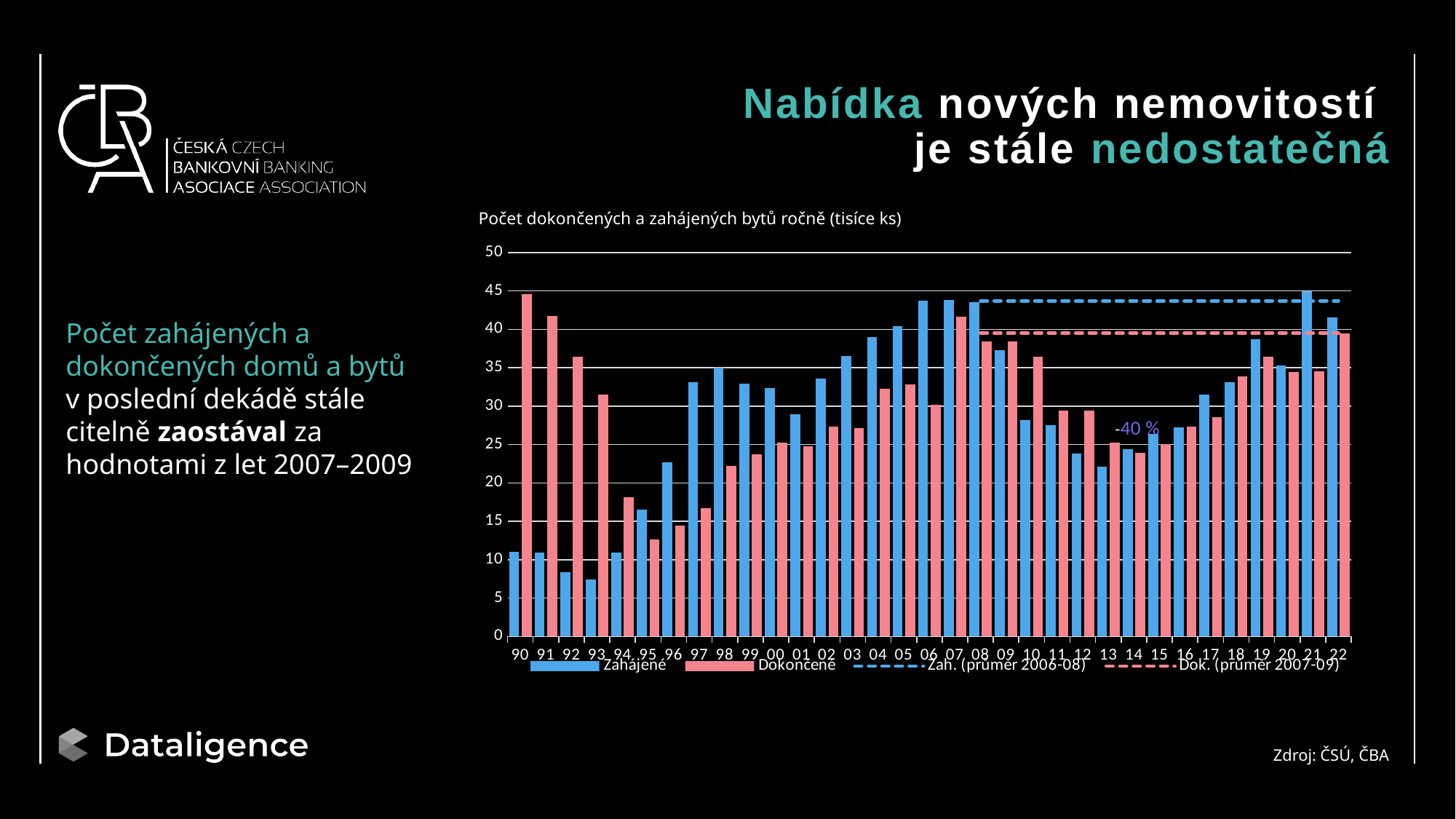
Which year has the highest Dokončené value? 90 Is the Zahájené value for 93 greater or less than 10? less Is the Zahájené value for 13 greater or less than 25? less What is the title of the chart? Počet dokončených a zahájených bytů ročně (tisíce ks) Is the Zahájené value for 21 greater or less than 40? greater How many series does the chart legend list? 4 Which year has the lowest Zahájené value? 93 How many years are shown on the x axis of the chart? 33 Which year has the lowest Dokončené value? 95 What kind of chart is shown on the slide? bar chart In 21, which is larger: Zahájené or Dokončené? Zahájené